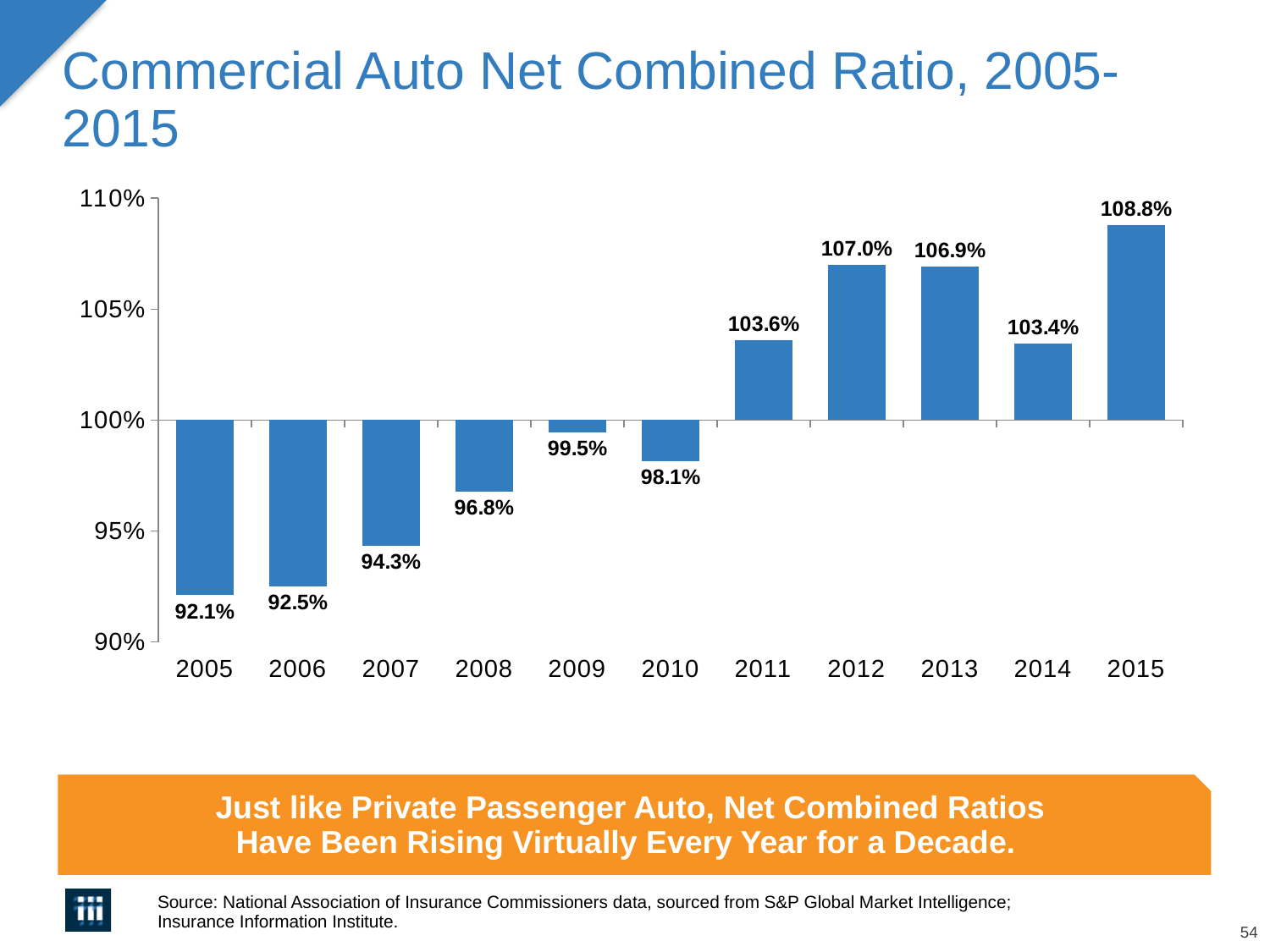
Which year has the highest net combined ratio? 2015 What is the value shown for 2012? 107.0% What is the overall trend of the net combined ratio from 2005 to 2015? Rising What is the commercial auto net combined ratio for 2009? 99.5% What is the difference between the 2015 and 2005 net combined ratios? 16.7 percentage points Which year has the lowest net combined ratio? 2005 How many years are shown on the chart? 11 What type of chart is shown on the slide? Bar chart What is the commercial auto net combined ratio for 2015? 108.8% Is the value for 2010 greater or less than 100%? less Which year has a higher net combined ratio, 2011 or 2014? 2011 What is the difference between the 2014 and 2013 values? 3.5 percentage points